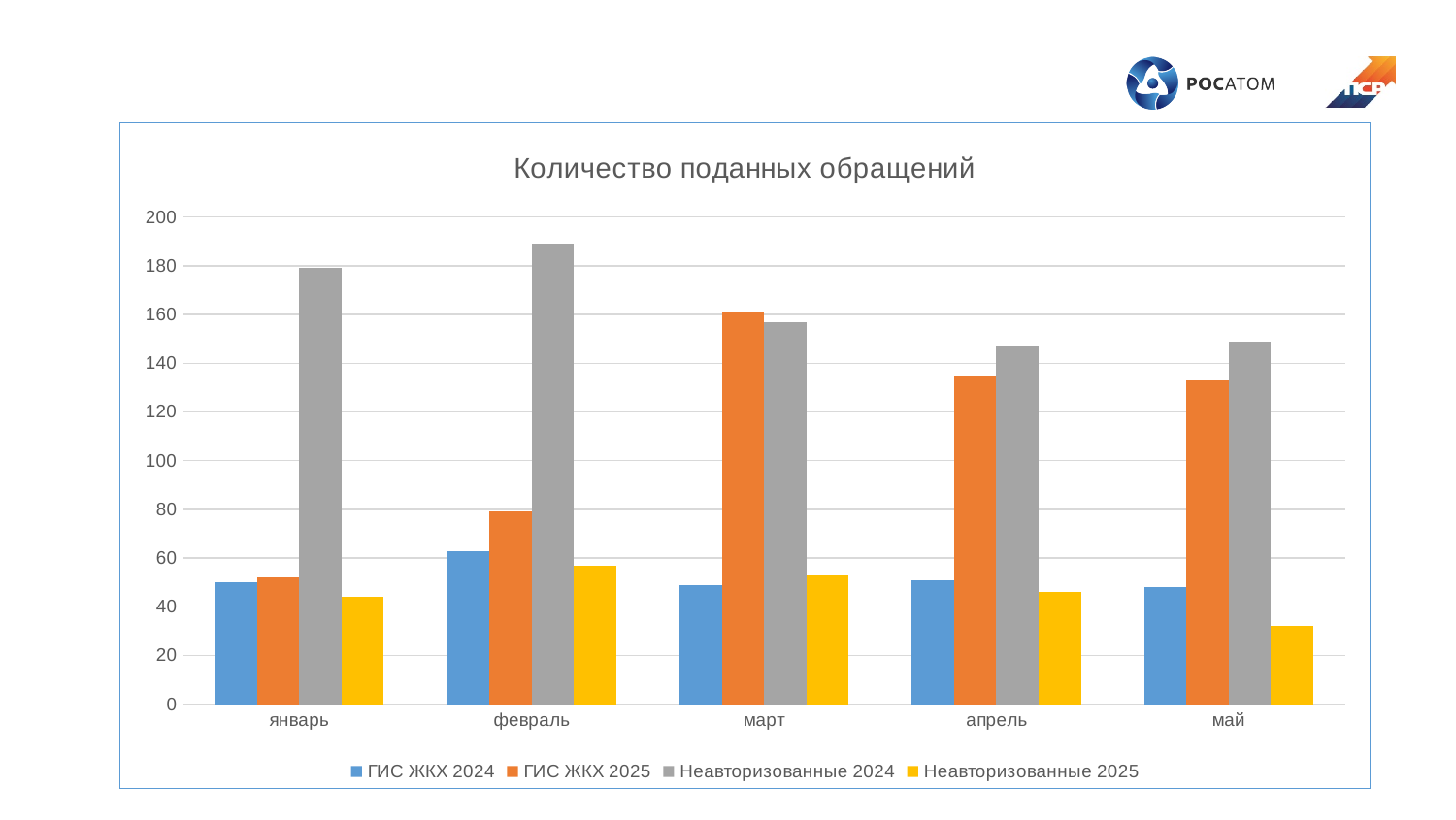
In апрель, which is larger: ГИС ЖКХ 2025 or Неавторизованные 2024? Неавторизованные 2024 In which month is the value for ГИС ЖКХ 2025 the highest? март How many series does the legend list? 4 How many months are shown on the x axis of the chart? 5 Does the value for Неавторизованные 2025 rise or fall from март to май? fall Is the value for ГИС ЖКХ 2025 in март greater or less than 140? greater Is the value for Неавторизованные 2024 in январь greater or less than 160? greater What is the title of the chart? Количество поданных обращений What kind of chart is shown on the slide? bar chart Is the value for ГИС ЖКХ 2025 in январь greater or less than 60? less In which month is the value for Неавторизованные 2025 the lowest? май In which month is the value for Неавторизованные 2024 the highest? февраль